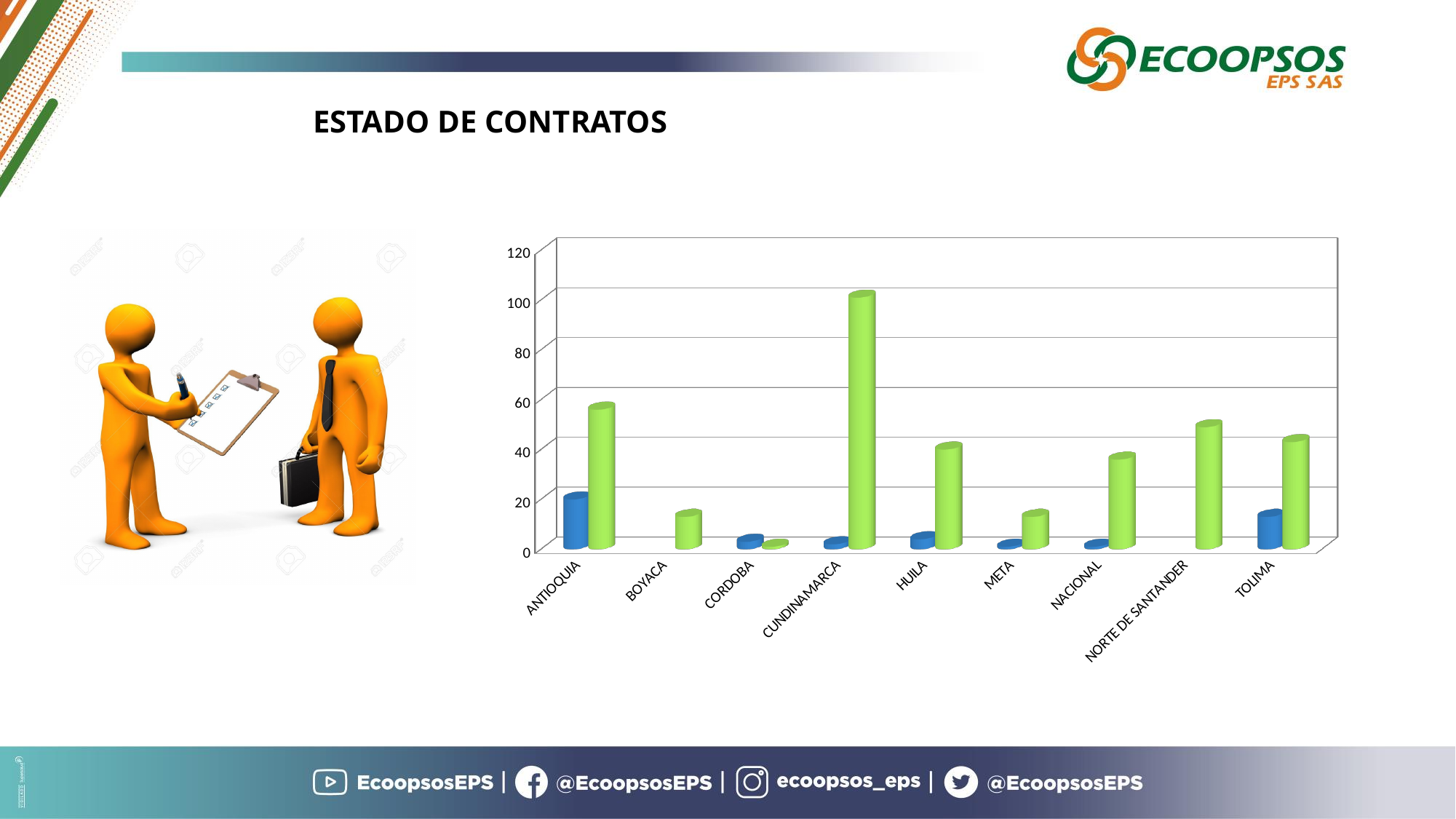
Which category has the tallest blue bar? ANTIOQUIA How many categories are shown on the x axis of the chart? 9 Which category has the shortest green bar? CORDOBA Which category has the tallest green bar? CUNDINAMARCA Is the green bar for BOYACA greater or less than 20? less Is the green bar for CUNDINAMARCA greater or less than 80? greater Which has the taller green bar, ANTIOQUIA or BOYACA? ANTIOQUIA What kind of chart is shown on the slide? bar chart Is the blue bar for TOLIMA greater or less than 20? less What is the title shown above the chart on the slide? ESTADO DE CONTRATOS Which has the taller green bar, CUNDINAMARCA or TOLIMA? CUNDINAMARCA